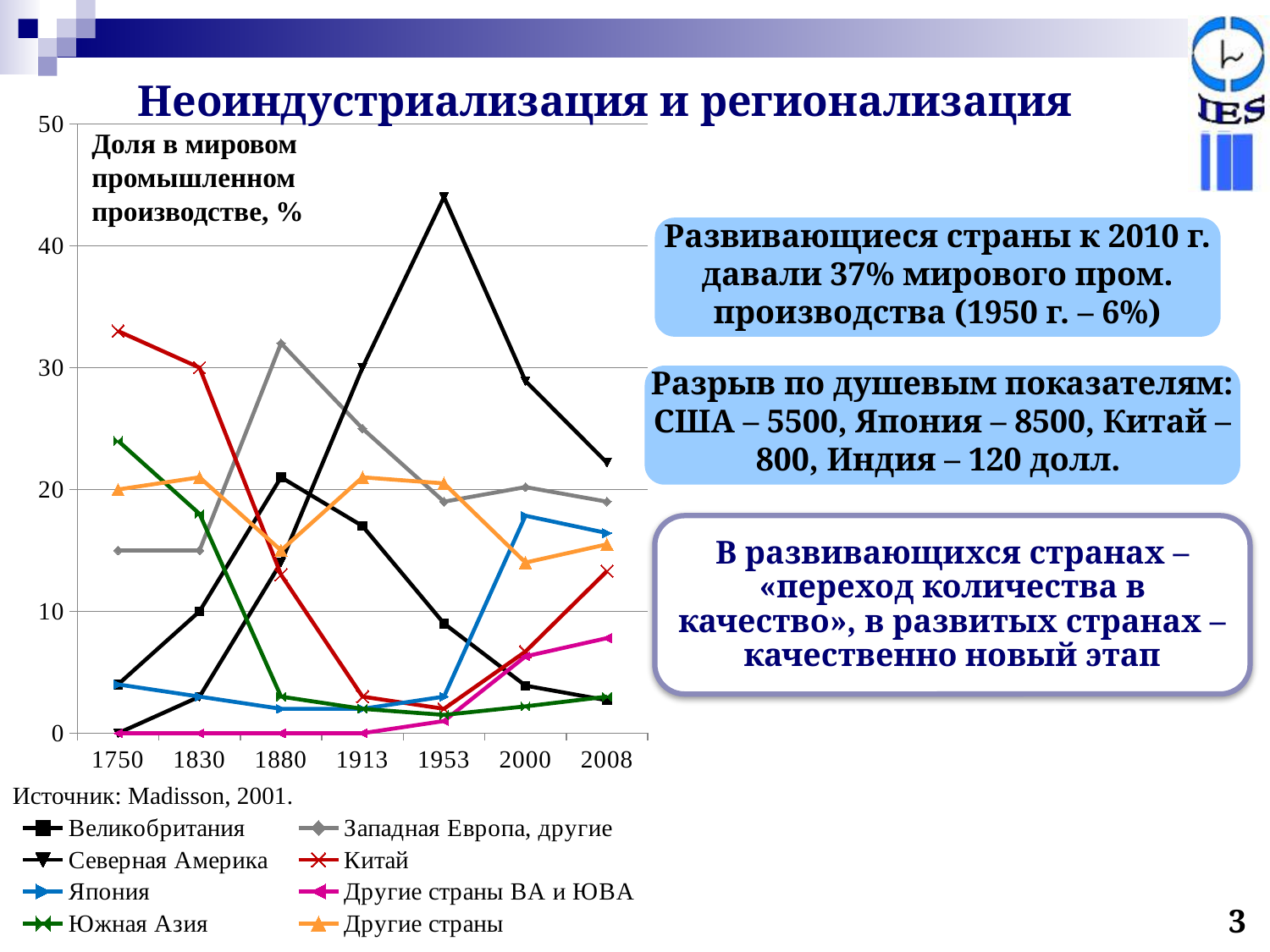
Is the value for Северная Америка in 1953 greater or less than 40? greater Which series has the highest value in 1750? Китай Is the value for Западная Европа, другие in 1880 greater or less than 30? greater In 2000, which series has the larger value: Япония or Китай? Япония Does the value for Северная Америка rise or fall from 1953 to 2008? fall What kind of chart is shown on the slide? line chart How many years are marked along the x axis of the chart? 7 Which series has the highest value in 1953? Северная Америка Is the value for Китай in 1750 greater or less than 30? greater What is the y-axis label of the chart? Доля в мировом промышленном производстве, % How many series does the chart legend list? 8